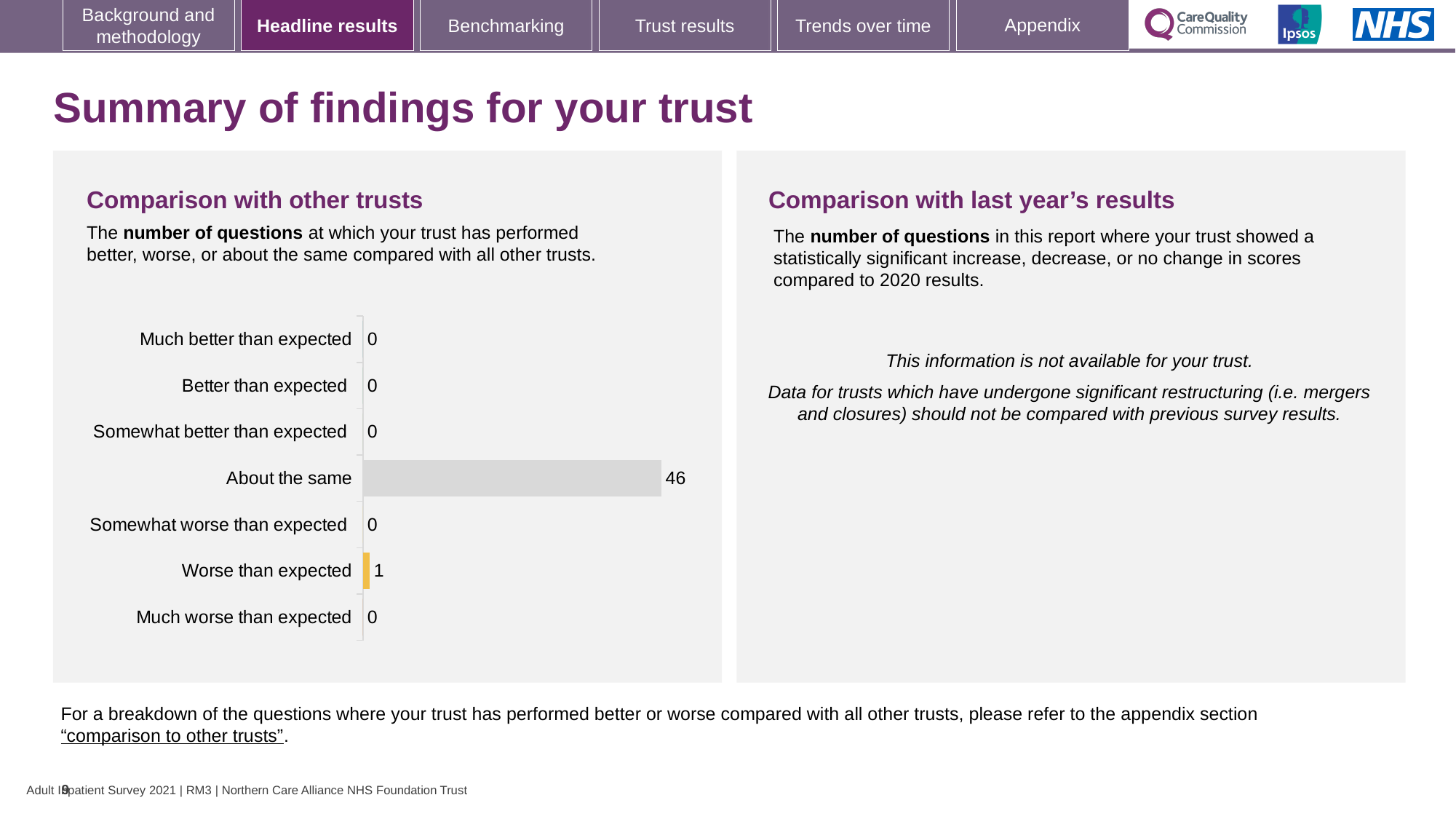
Which category has the highest value? About the same What is the value for "Somewhat worse than expected"? 0 What is the value for "Much better than expected"? 0 What kind of chart is shown on the slide? Bar chart What is the difference between the values for "About the same" and "Worse than expected"? 45 What is the total of all the values shown in the chart? 47 What is the value for "Worse than expected"? 1 What is the heading above the chart? Comparison with other trusts What is the value for "About the same"? 46 How many categories are shown in the chart? 7 How many categories in the chart have a value of 0? 5 Which is larger, the value for "Worse than expected" or the value for "Better than expected"? Worse than expected